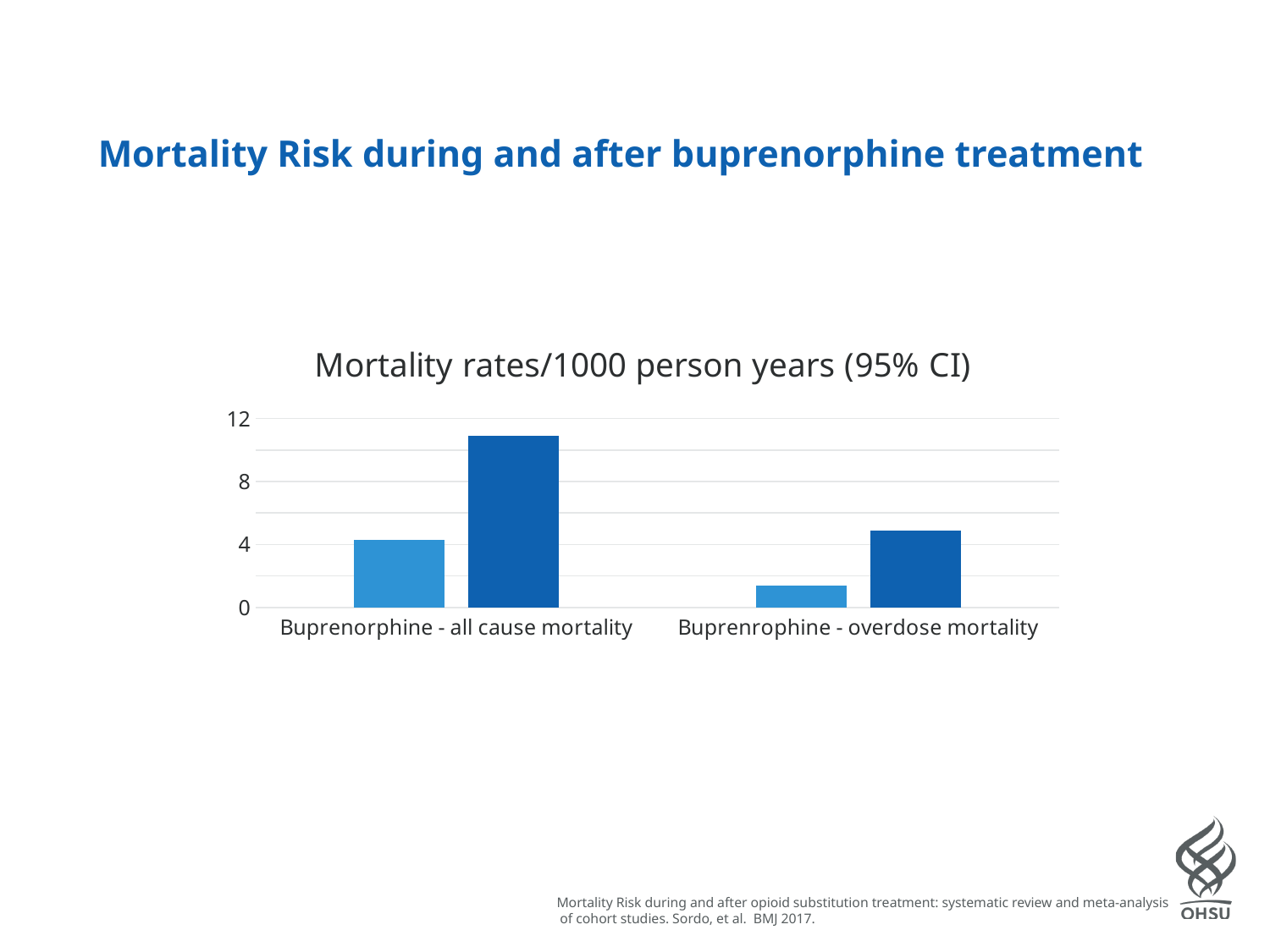
Which category contains the tallest bar in the chart? Buprenorphine - all cause mortality Which category contains the shortest bar in the chart? Buprenrophine - overdose mortality Is the dark blue bar for Buprenrophine - overdose mortality greater or less than 8? less For Buprenorphine - all cause mortality, which bar is taller, the light blue bar or the dark blue bar? the dark blue bar What is the highest value shown on the y axis of the chart? 12 How many categories are shown on the x axis of the chart? 2 Is the dark blue bar for Buprenorphine - all cause mortality greater or less than 8? greater What kind of chart is shown on the slide? bar chart How many bars are plotted for each category in the chart? 2 Is the dark blue bar for Buprenorphine - all cause mortality greater or less than 12? less What is the title of the chart? Mortality rates/1000 person years (95% CI)